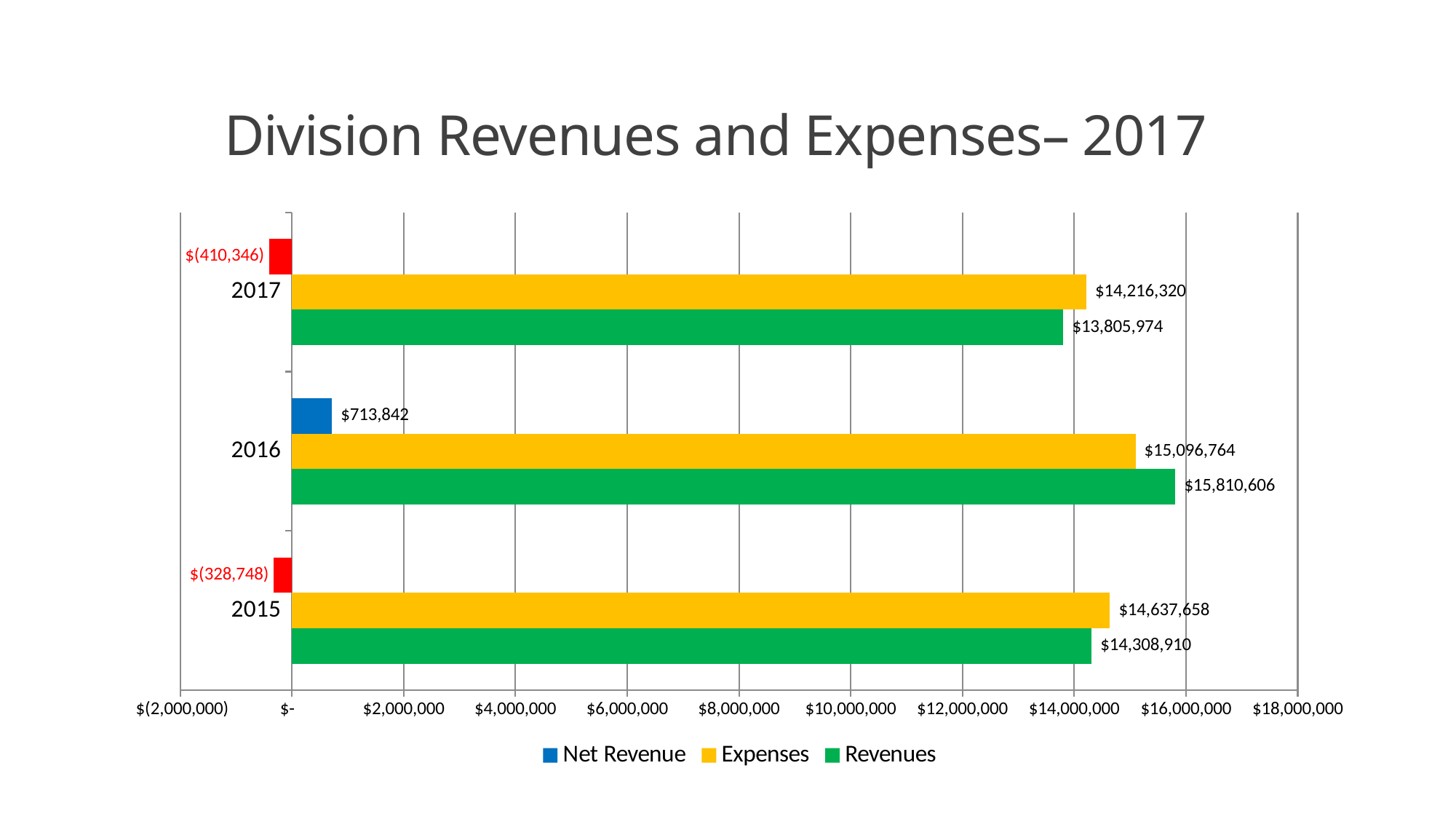
How many series does the legend list? 3 Which year had the highest Revenues? 2016 What were the Revenues in 2017? $13,805,974 What kind of chart is shown on the slide? Bar chart What were the Expenses in 2016? $15,096,764 What was the Net Revenue in 2016? $713,842 How many years are shown on the chart? 3 Were Revenues or Expenses larger in 2015? Expenses Which year had the lowest Expenses? 2017 What was the Net Revenue in 2015? $(328,748) What is the difference between Expenses and Revenues in 2017? $410,346 What is the title of the slide? Division Revenues and Expenses– 2017